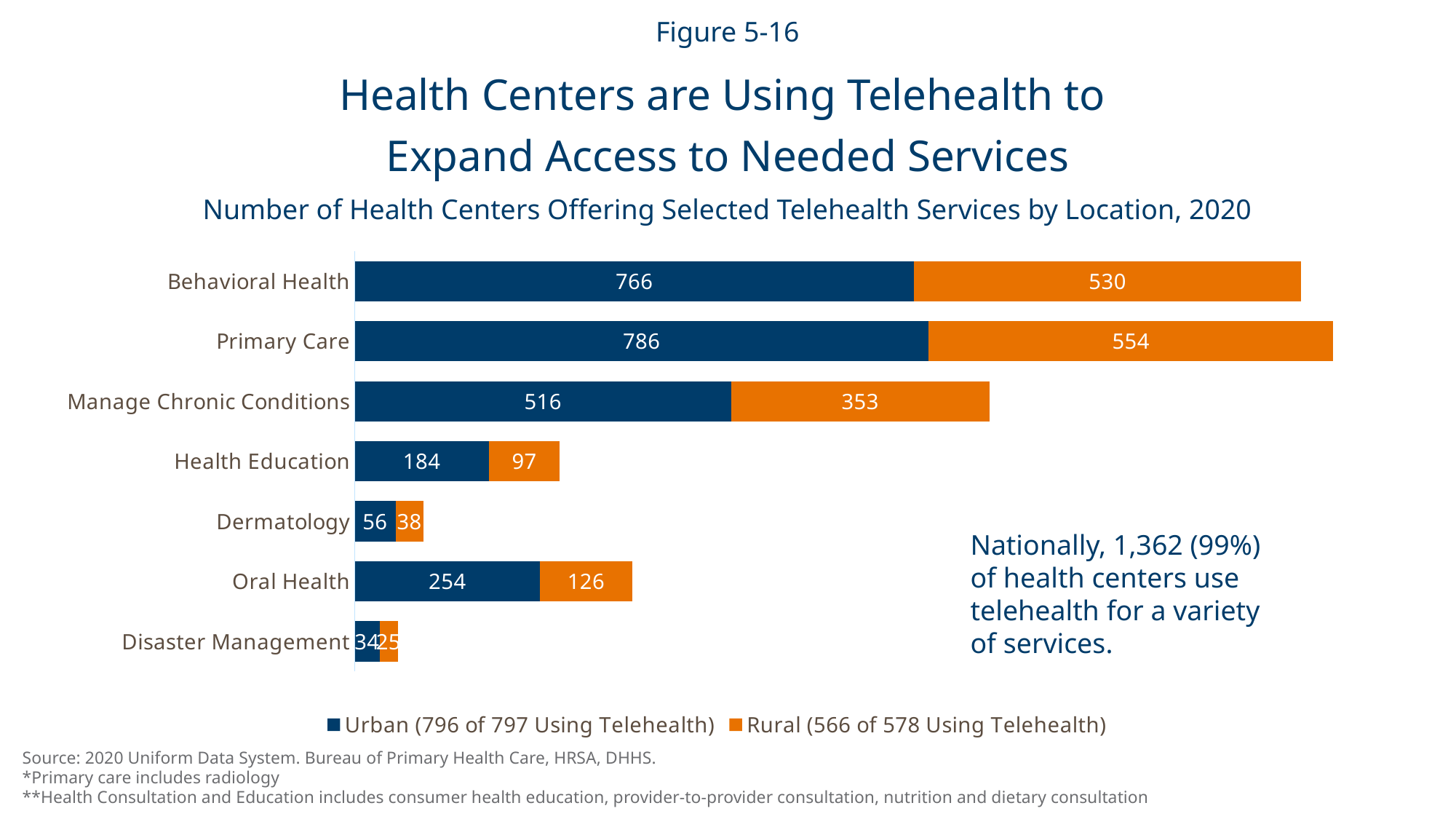
How many categories are shown on the chart? 7 What is the Rural value for Manage Chronic Conditions? 353 Which category has the lowest Rural value? Disaster Management What is the Urban value for Behavioral Health? 766 What is the total of the stacked bar for Dermatology? 94 What kind of chart is shown? Stacked bar chart What is the total of the stacked bar for Manage Chronic Conditions? 869 Which is larger, the Rural value for Primary Care or the Rural value for Behavioral Health? Primary Care How many series does the legend list? 2 What is the difference between the Urban and Rural values for Health Education? 87 Which category has the highest Urban value? Primary Care What is the Rural value for Oral Health? 126